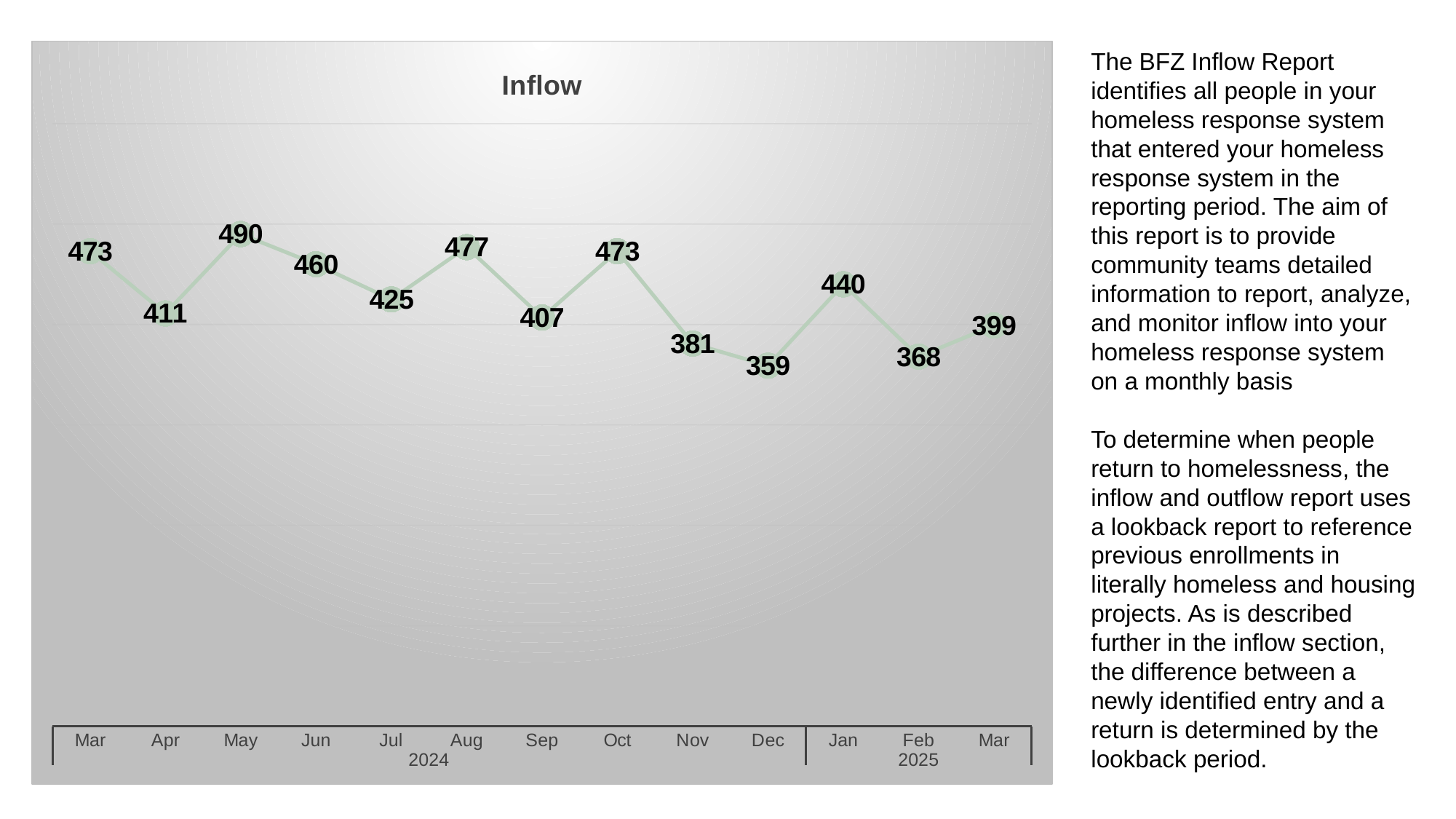
Which month has the highest inflow value? May 2024 What is the difference between the inflow values for Mar 2024 and Mar 2025? 74 How many monthly data points are plotted on the chart? 13 What is the inflow value for Dec 2024? 359 What is the title of the chart? Inflow What is the inflow value for May 2024? 490 What is the difference between the inflow values for Jan 2025 and Feb 2025? 72 What is the inflow value for Mar 2025? 399 Which is larger, the inflow value for Aug 2024 or Oct 2024? Aug 2024 Does the inflow value rise or fall from Nov 2024 to Dec 2024? fall Which month has the lowest inflow value? Dec 2024 What type of chart is shown on the slide? line chart